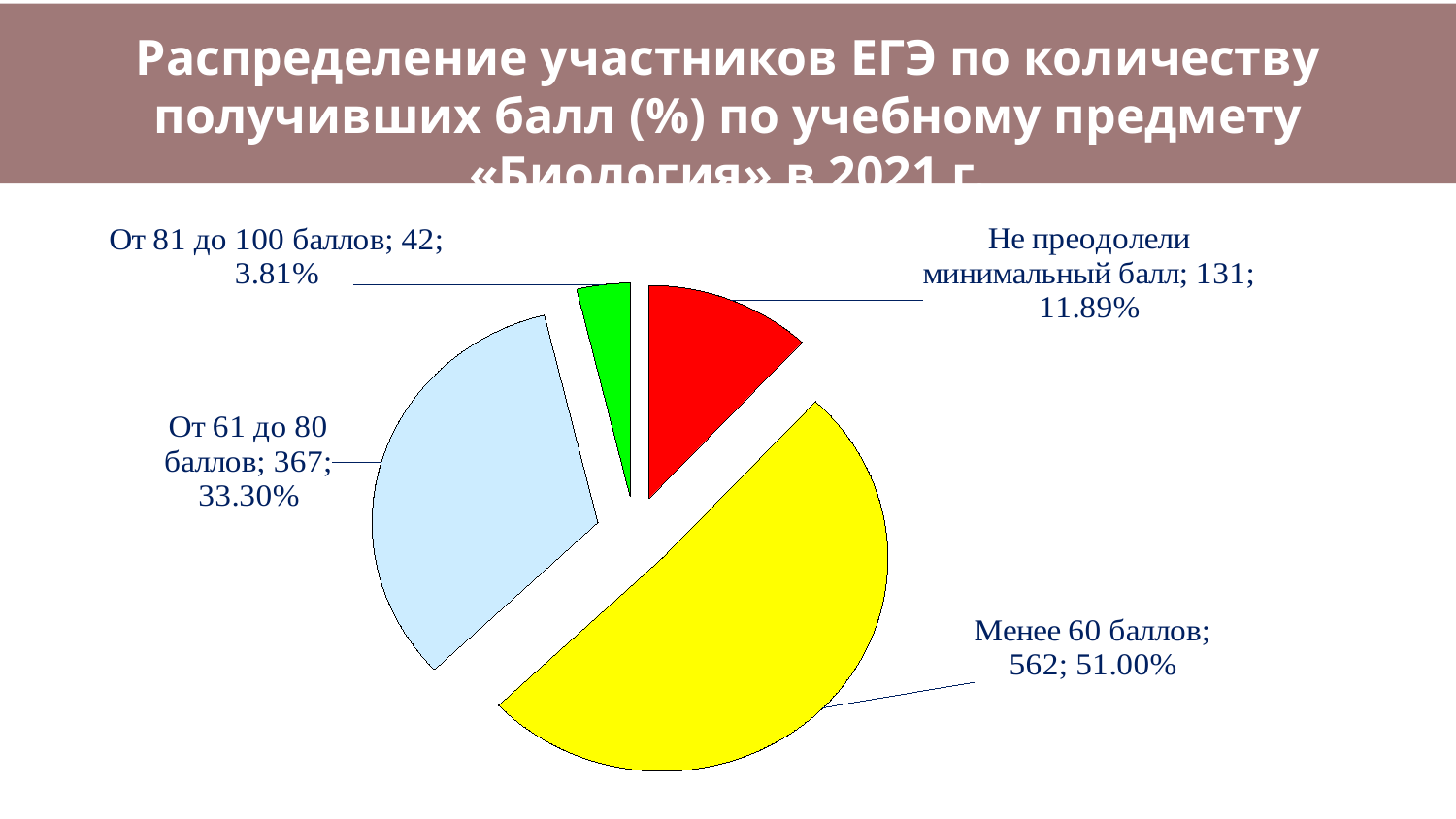
What is the total number of participants across all four slices? 1102 Which category has more participants: «Не преодолели минимальный балл» or «От 81 до 100 баллов»? Не преодолели минимальный балл How many participants did not pass the minimum score («Не преодолели минимальный балл»)? 131 Which category has the smallest slice of the pie? От 81 до 100 баллов How many participants are in the category «Менее 60 баллов»? 562 What colour is the slice for «Менее 60 баллов»? Yellow What is the difference in the number of participants between «Менее 60 баллов» and «От 61 до 80 баллов»? 195 What percentage share does the slice «От 61 до 80 баллов» have? 33.30% What kind of chart is shown on the slide? Pie chart How many slices does the pie chart have? 4 Which category has the largest slice of the pie? Менее 60 баллов What percentage of participants scored «От 81 до 100 баллов»? 3.81%